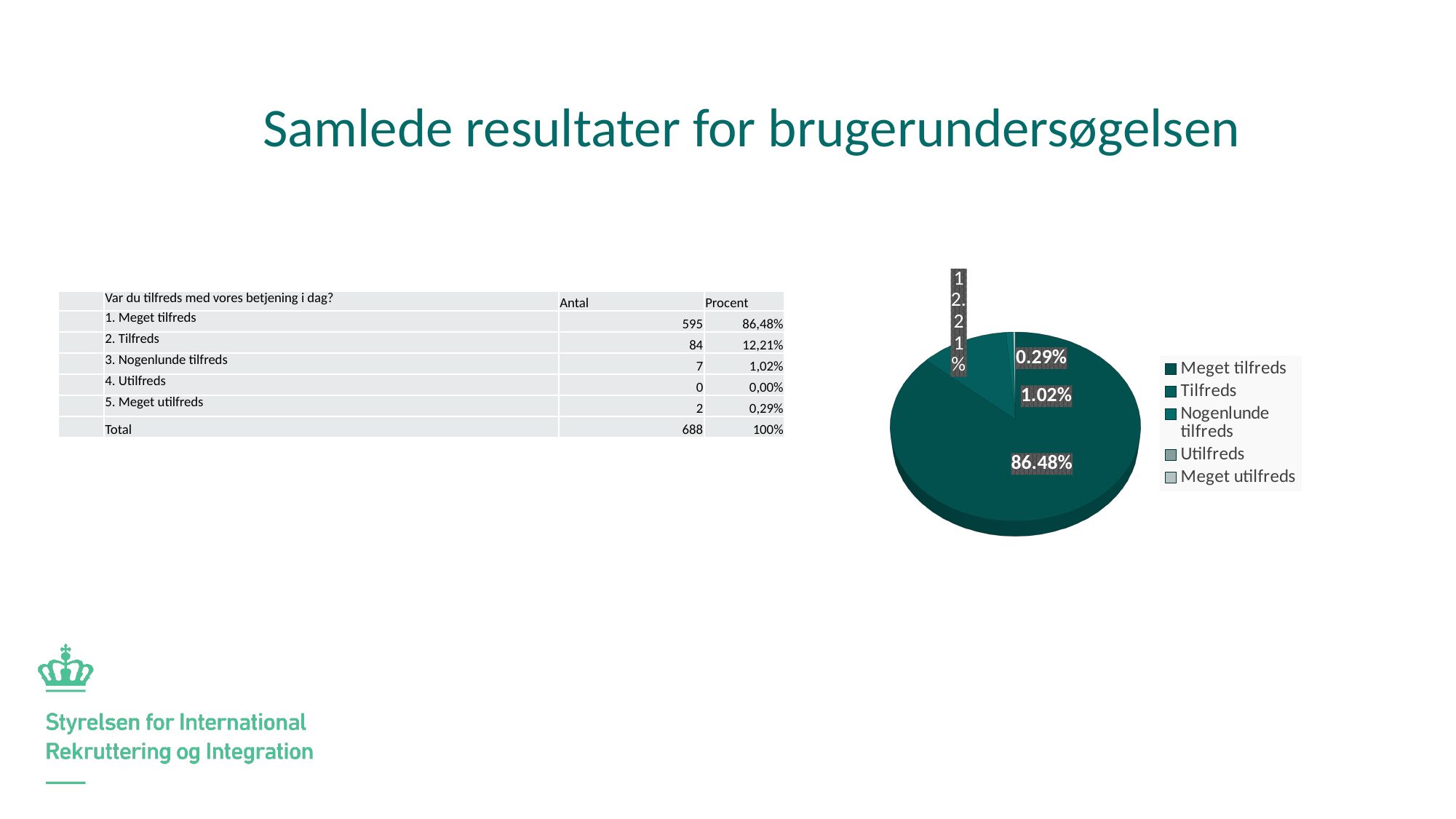
Which of the two slices is larger, Tilfreds or Nogenlunde tilfreds? Tilfreds Which category has the largest slice of the pie chart? Meget tilfreds What is the difference in percentage points between the Meget tilfreds slice and the Tilfreds slice? 74.27 Which legend entry is listed last in the pie chart's legend? Meget utilfreds What kind of chart is shown on the slide? pie chart How many entries does the legend of the pie chart list? 5 What share of the pie does the Nogenlunde tilfreds slice have? 1.02% What share of the pie does the Meget utilfreds slice have? 0.29% What share of the pie does the Meget tilfreds slice have? 86.48% Which legend entry is listed first in the pie chart's legend? Meget tilfreds